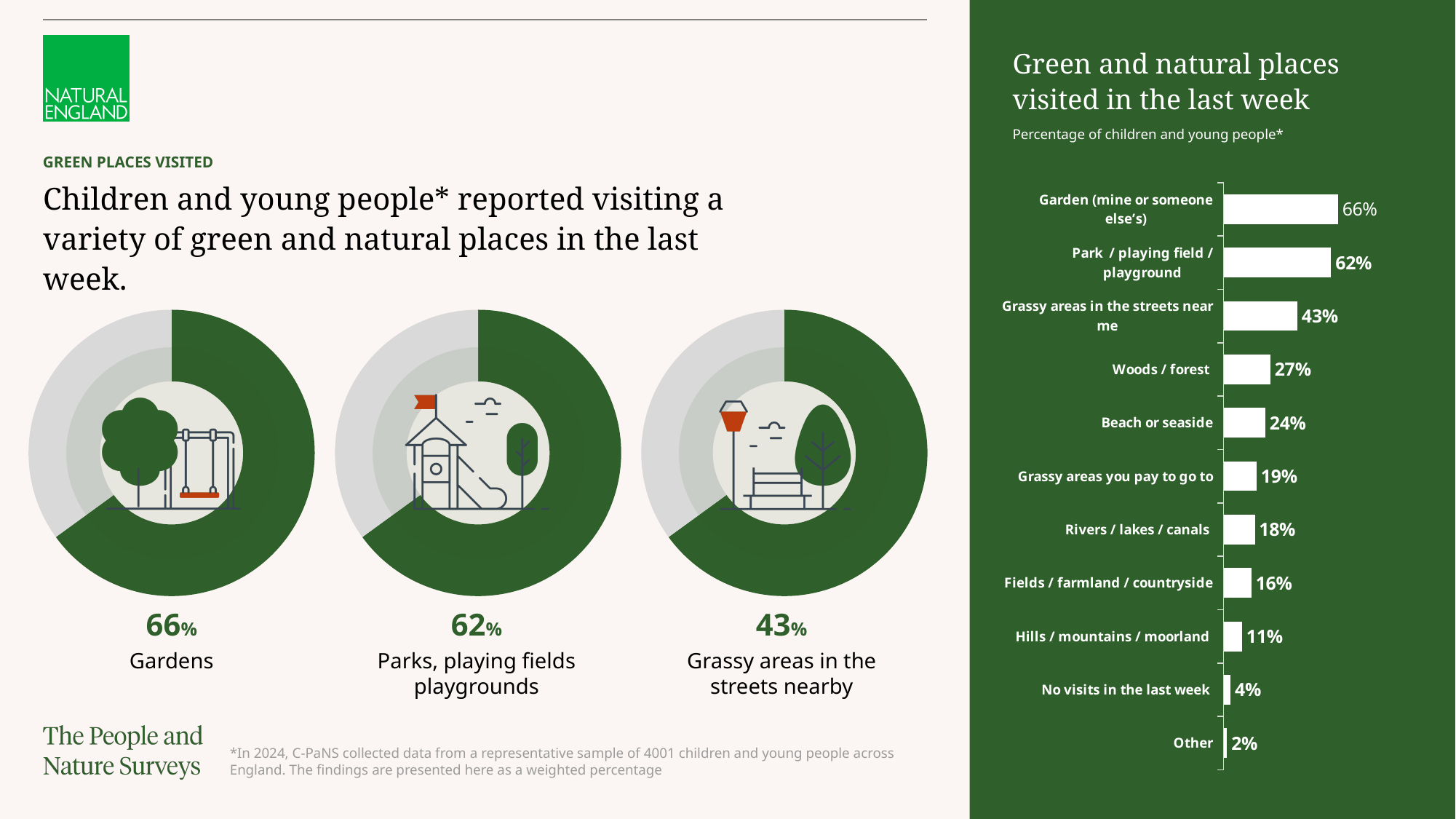
In the 'Green and natural places visited in the last week' bar chart, which category has the highest value? Garden (mine or someone else's) In the donut chart on the left of the slide, what percentage is shown for Gardens? 66% In the 'Green and natural places visited in the last week' bar chart, which category has the lowest value? Other In the 'Green and natural places visited in the last week' bar chart, what is the difference between the values for Park / playing field / playground and Grassy areas in the streets near me? 19% In the 'Green and natural places visited in the last week' bar chart, what percentage is shown for Hills / mountains / moorland? 11% In the 'Green and natural places visited in the last week' bar chart, which is larger: Rivers / lakes / canals or Fields / farmland / countryside? Rivers / lakes / canals What is the subtitle under the title of the bar chart on the right of the slide? Percentage of children and young people* In the middle donut chart, what percentage is shown for Parks, playing fields, playgrounds? 62% What kind of chart is the 'Green and natural places visited in the last week' chart on the right of the slide? Bar chart In the 'Green and natural places visited in the last week' bar chart, what percentage is shown for Woods / forest? 27% In the 'Green and natural places visited in the last week' bar chart, what percentage is shown for Beach or seaside? 24% How many categories are shown in the 'Green and natural places visited in the last week' bar chart? 11